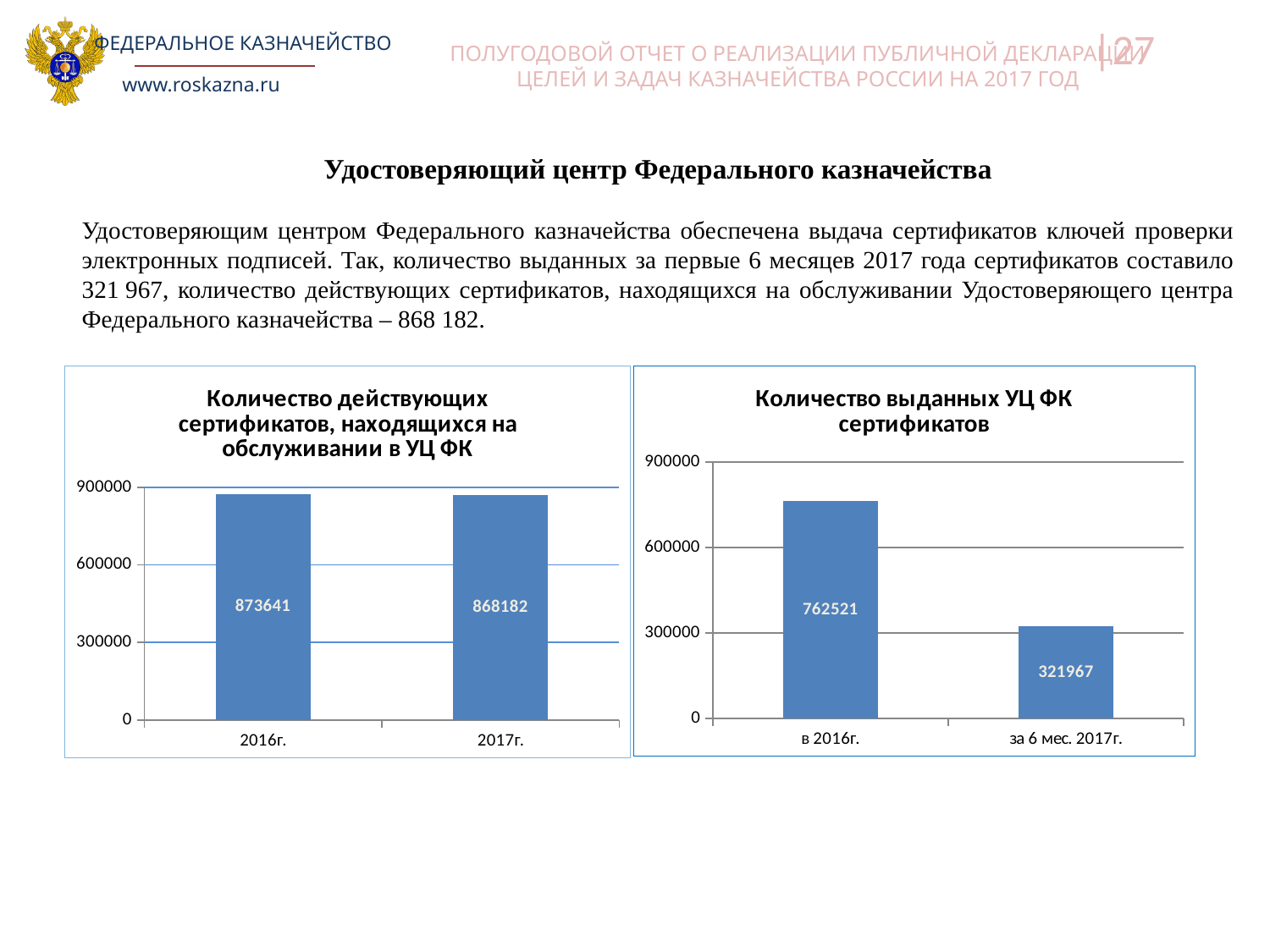
What type of chart is the left chart (Количество действующих сертификатов, находящихся на обслуживании в УЦ ФК)? bar chart In the left chart (Количество действующих сертификатов, находящихся на обслуживании в УЦ ФК), what is the value for 2017г.? 868182 In the left chart (Количество действующих сертификатов, находящихся на обслуживании в УЦ ФК), what is the value for 2016г.? 873641 In the left chart (Количество действующих сертификатов, находящихся на обслуживании в УЦ ФК), is the value for 2017г. greater or less than 600000? greater In the right chart (Количество выданных УЦ ФК сертификатов), what is the difference between the value for в 2016г. and the value for за 6 мес. 2017г.? 440554 In the right chart (Количество выданных УЦ ФК сертификатов), what is the value for в 2016г.? 762521 In the right chart (Количество выданных УЦ ФК сертификатов), is the value for за 6 мес. 2017г. greater or less than 600000? less In the right chart (Количество выданных УЦ ФК сертификатов), what is the value for за 6 мес. 2017г.? 321967 In the right chart (Количество выданных УЦ ФК сертификатов), which category has the highest value? в 2016г. How many categories are shown in the right chart (Количество выданных УЦ ФК сертификатов)? 2 In the left chart (Количество действующих сертификатов, находящихся на обслуживании в УЦ ФК), what is the difference between the value for 2016г. and the value for 2017г.? 5459 In the right chart (Количество выданных УЦ ФК сертификатов), which category has the lowest value? за 6 мес. 2017г.